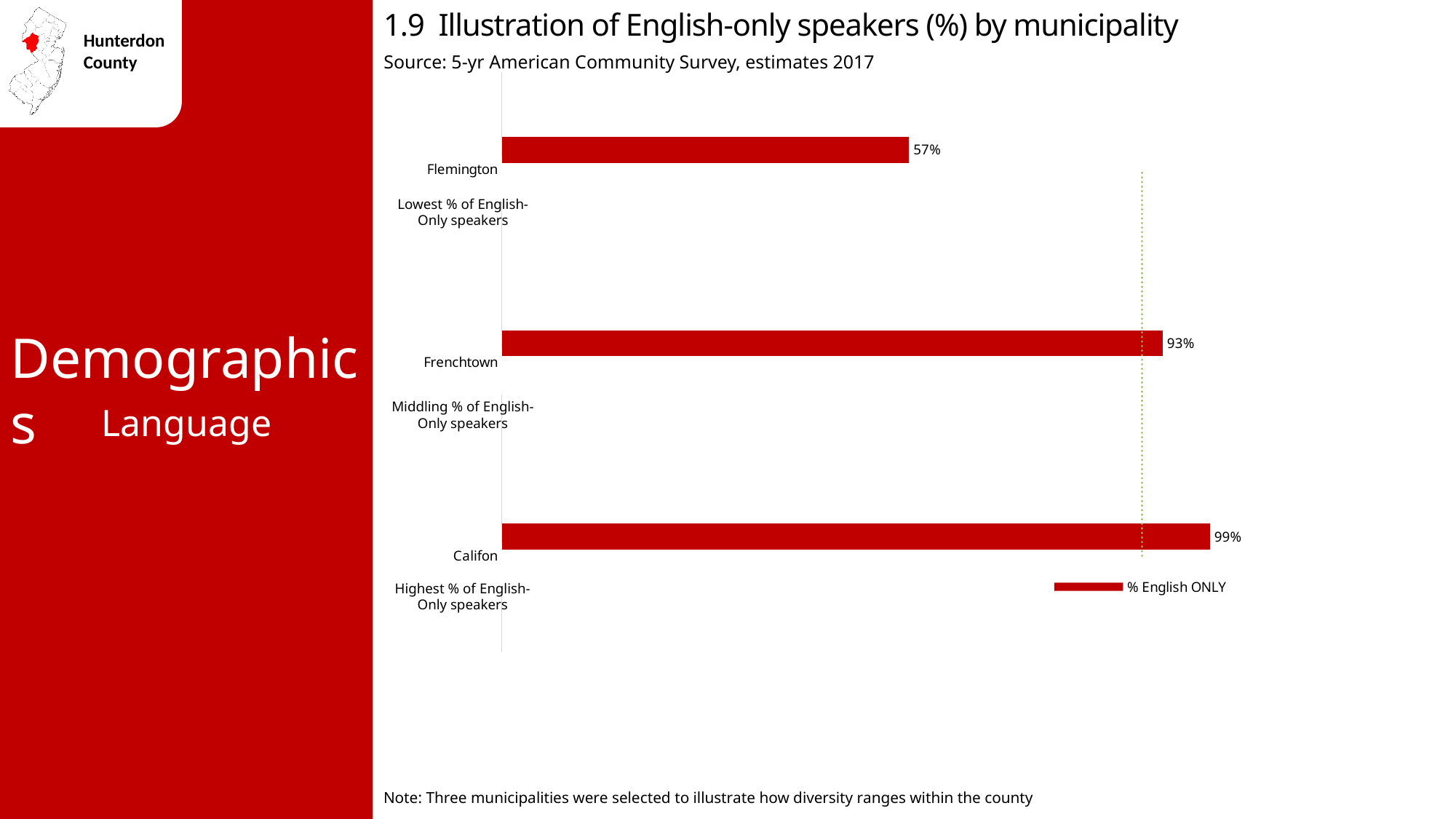
Which has a higher percentage of English-only speakers, Frenchtown or Flemington? Frenchtown What is the percentage of English-only speakers in Califon? 99% What is the legend entry for the series shown in the chart? % English ONLY What is the difference in percentage points between Frenchtown and Flemington? 36 Which municipality has the highest percentage of English-only speakers? Califon Which municipality has the lowest percentage of English-only speakers? Flemington What is the difference in percentage points between Califon and Flemington? 42 How many series does the legend list? 1 What is the percentage of English-only speakers in Frenchtown? 93% What is the percentage of English-only speakers in Flemington? 57% What kind of chart is shown on the slide? Bar chart How many municipalities are shown in the chart? 3